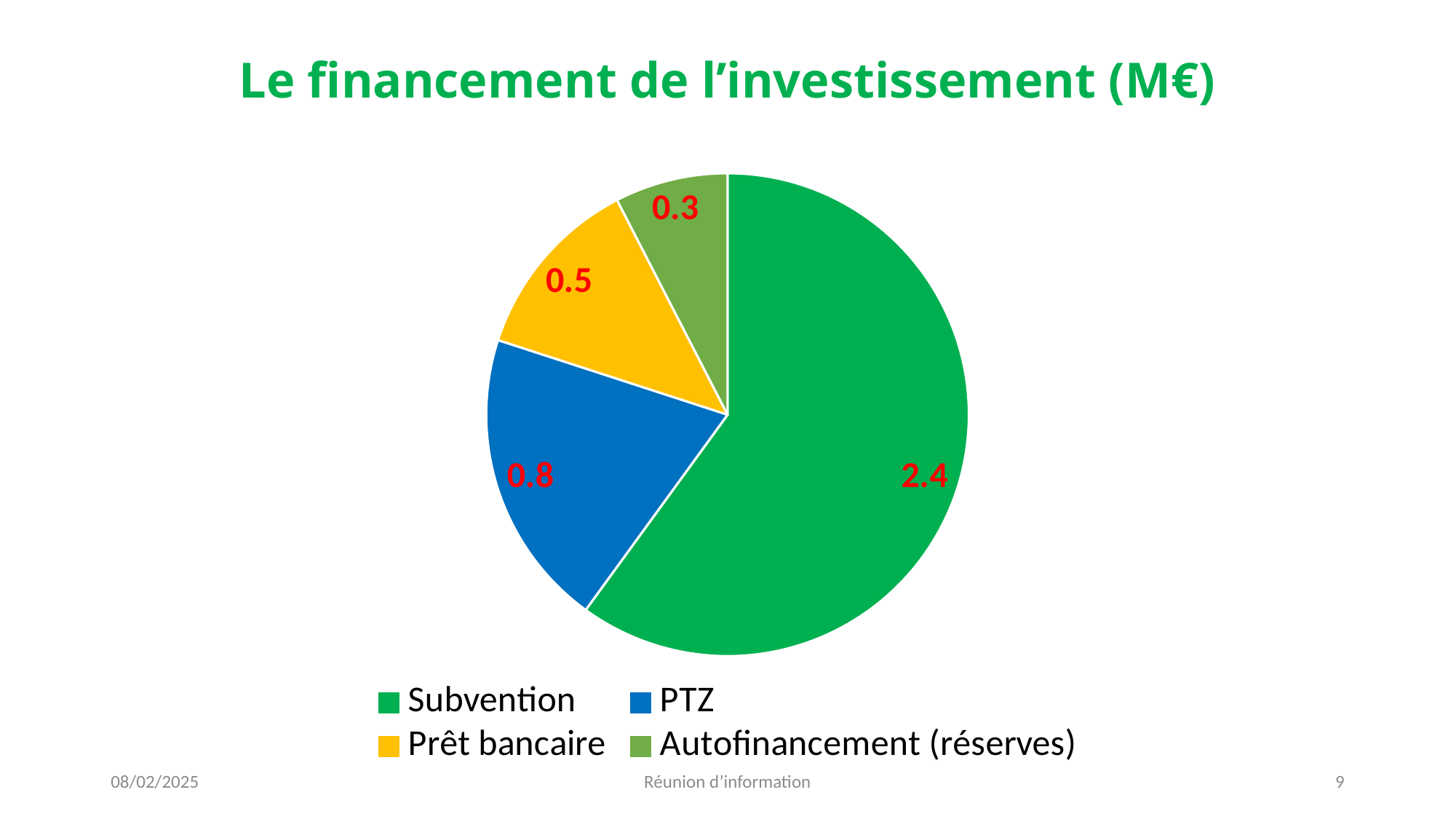
What type of chart is shown on the slide? pie chart What is the value for Autofinancement (réserves)? 0.3 Which category has the largest slice of the pie? Subvention What is the difference between the values for Subvention and PTZ? 1.6 Which is larger, the value for PTZ or the value for Prêt bancaire? PTZ What is the value for Prêt bancaire? 0.5 What is the value for Subvention? 2.4 Which category has the smallest slice of the pie? Autofinancement (réserves) What is the value for PTZ? 0.8 What is the title of the chart? Le financement de l’investissement (M€) What share of the pie does Subvention represent? 60% How many categories does the pie chart show? 4